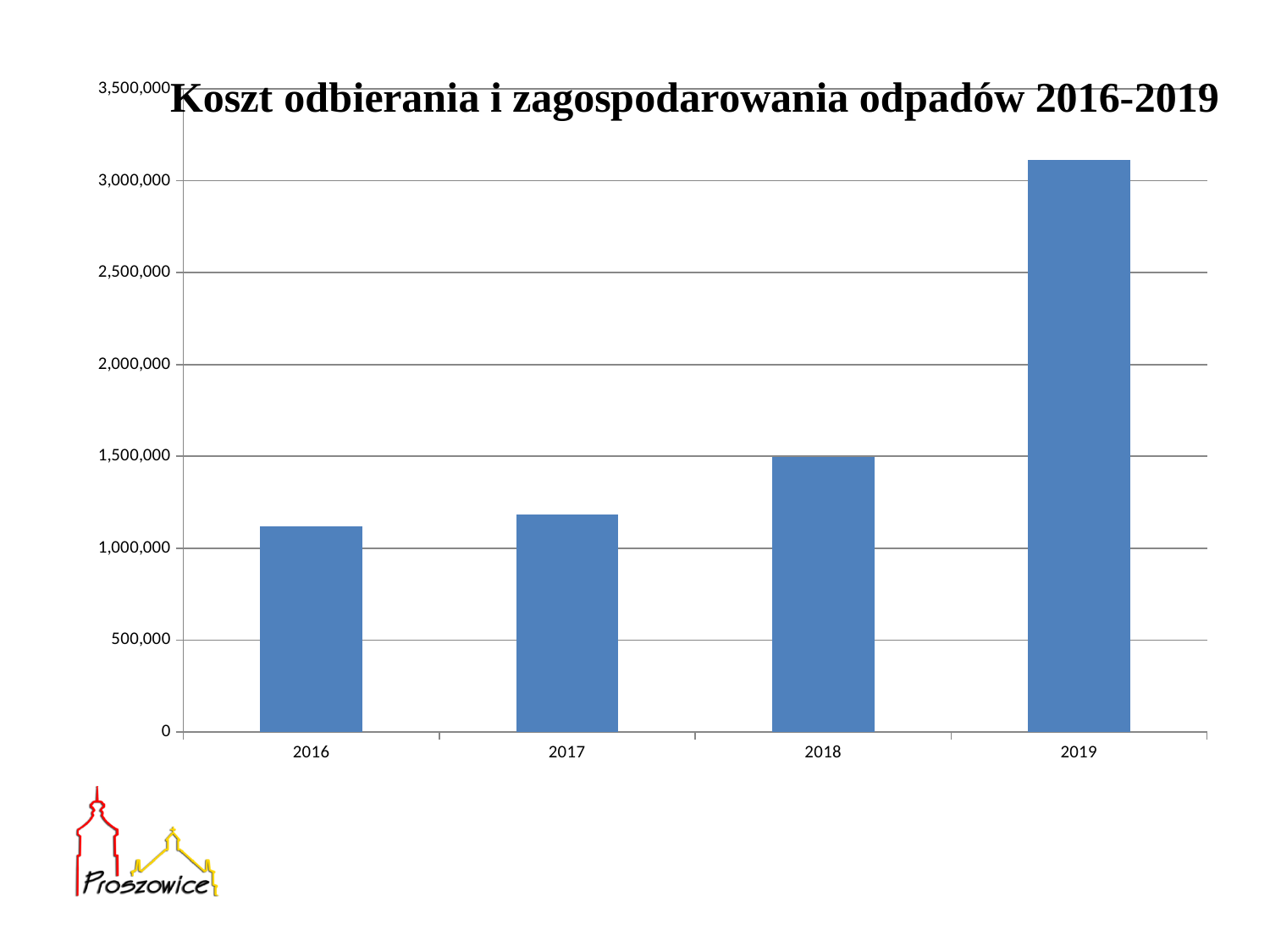
Is the value for 2019 greater or less than 3,500,000? less Which year has the lowest cost in the chart? 2016 How many years are shown on the x axis of the chart? 4 Is the value for 2017 greater or less than 1,000,000? greater Is the value for 2019 greater or less than 3,000,000? greater What is the title of the chart? Koszt odbierania i zagospodarowania odpadów 2016-2019 Which is larger, the value for 2018 or the value for 2019? 2019 Which is larger, the value for 2017 or the value for 2018? 2018 Which year has the highest cost in the chart? 2019 Do the values rise or fall from 2016 to 2019? rise What kind of chart is shown on the slide? bar chart